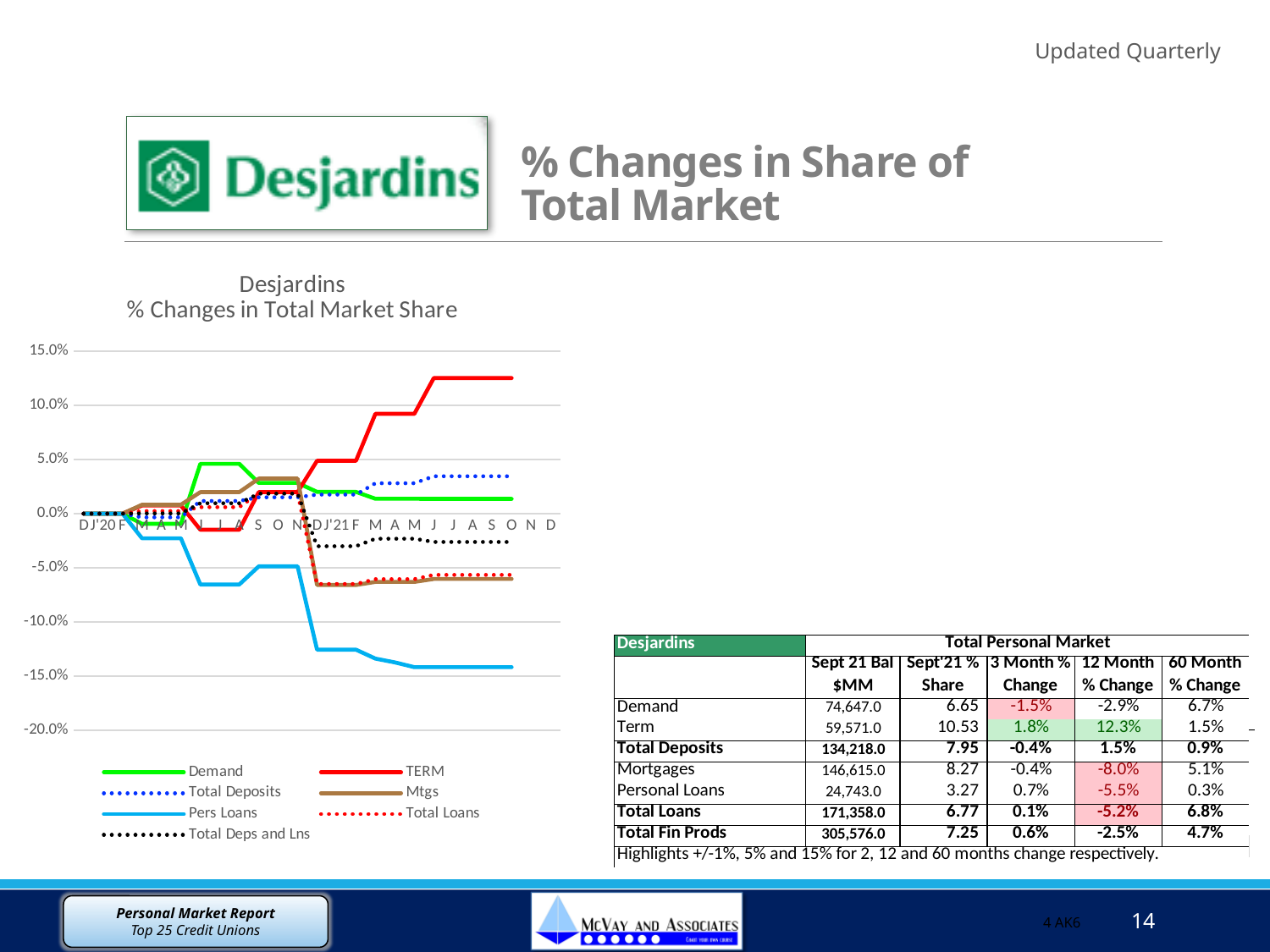
Does the TERM series rise or fall over the period shown? rise Which series has the highest value at the end of the period (D 2021)? TERM How many series does the chart legend list? 7 Which series has the lowest value at the end of the period (D 2021)? Pers Loans Is the value for Total Deposits at the end of the period greater or less than 0.0%? greater Does the Pers Loans series rise or fall over the period shown? fall What is the title of the chart? Desjardins % Changes in Total Market Share Is the value for Pers Loans at the end of the period greater or less than -10.0%? less At the end of the period, which is larger: TERM or Demand? TERM Is the value for Mtgs at the end of the period greater or less than -5.0%? less What kind of chart is shown on the slide? line chart